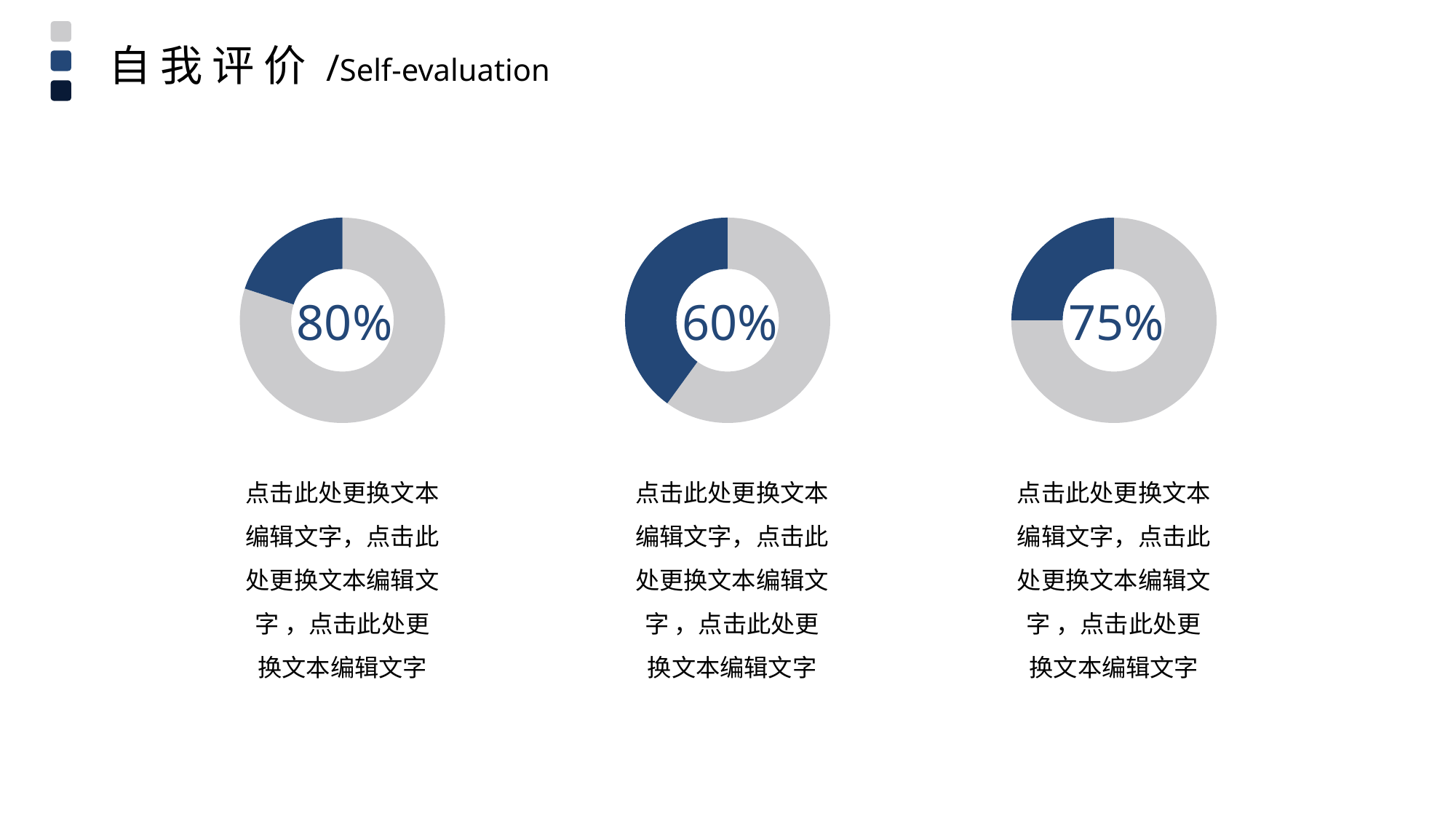
What two colours are used for the segments of each donut chart? dark blue and grey Which printed percentage is larger, the one in the right donut chart or the one in the middle donut chart? right donut chart What kind of chart is used on this slide? donut chart Which of the three donut charts shows the lowest printed percentage: left, middle or right? middle What is the difference between the percentage printed in the right donut chart and the percentage printed in the middle donut chart? 15% What percentage is printed in the centre of the middle donut chart? 60% What is the difference between the percentage printed in the left donut chart and the percentage printed in the middle donut chart? 20% How many donut charts are shown on the slide? 3 What is the title of the slide containing the three donut charts? 自我评价 /Self-evaluation What percentage is printed in the centre of the left donut chart? 80% What percentage is printed in the centre of the right donut chart? 75% Which of the three donut charts shows the highest printed percentage: left, middle or right? left